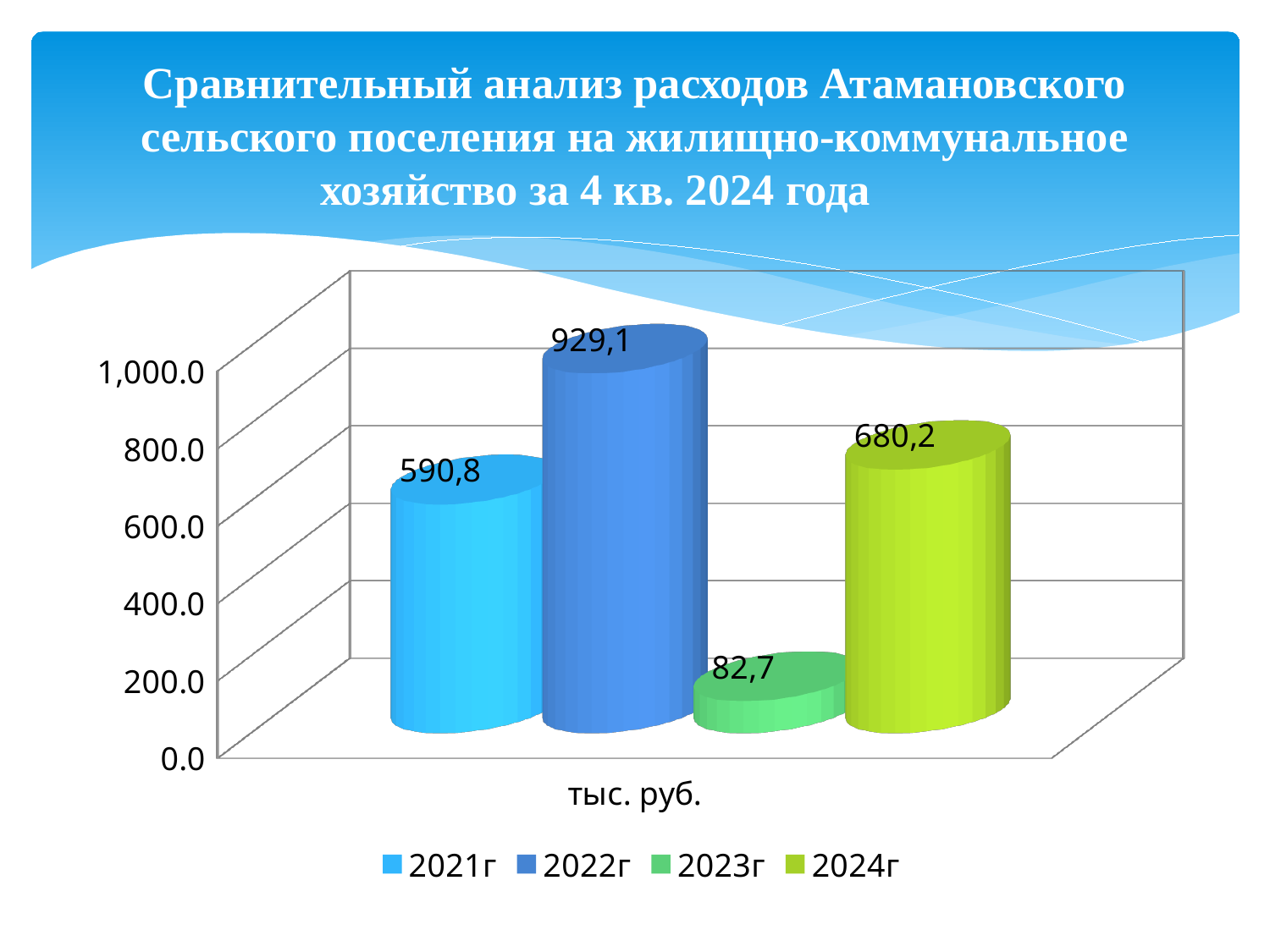
What is the difference between the values for 2024г and 2023г? 597,5 Which is larger, the value for 2024г or the value for 2021г? 2024г Which year has the highest value? 2022г How many series does the legend list? 4 What unit label is shown under the x axis of the chart? тыс. руб. What kind of chart is shown on the slide? Bar chart What is the value for 2021г? 590,8 Which year has the lowest value? 2023г What is the difference between the values for 2022г and 2021г? 338,3 What is the value for 2024г? 680,2 What is the value for 2022г? 929,1 What is the value for 2023г? 82,7